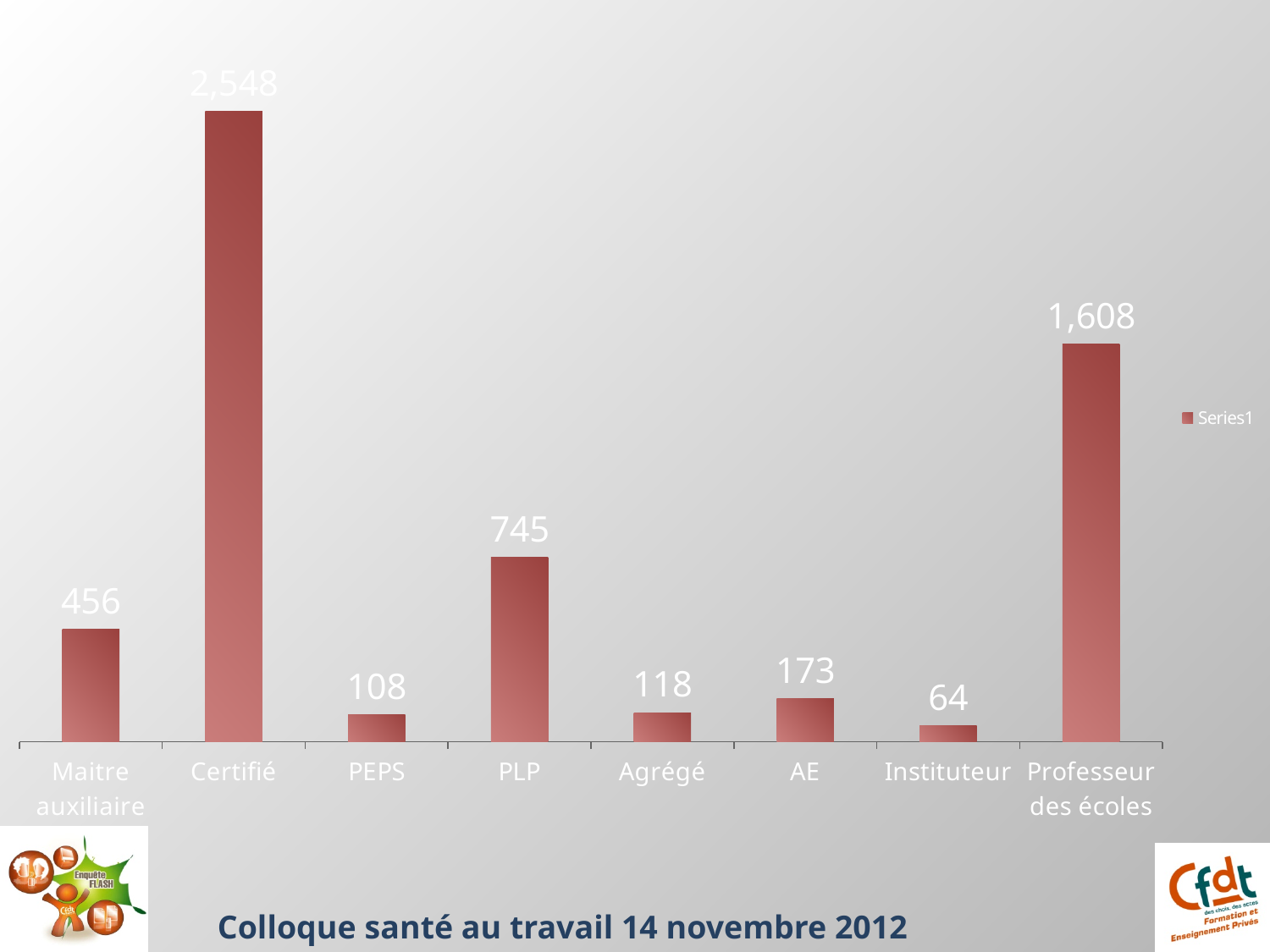
How many categories are shown on the x axis? 8 What is the value for Professeur des écoles? 1,608 How many series does the legend list? 1 What is the difference between the values for PLP and Maitre auxiliaire? 289 Which category has the lowest value? Instituteur What is the value for PLP? 745 Which is larger, the value for AE or the value for Agrégé? AE Which category has the highest value? Certifié What is the value for Certifié? 2,548 What is the value for Instituteur? 64 What is the difference between the values for Certifié and Professeur des écoles? 940 What kind of chart is shown on the slide? Bar chart